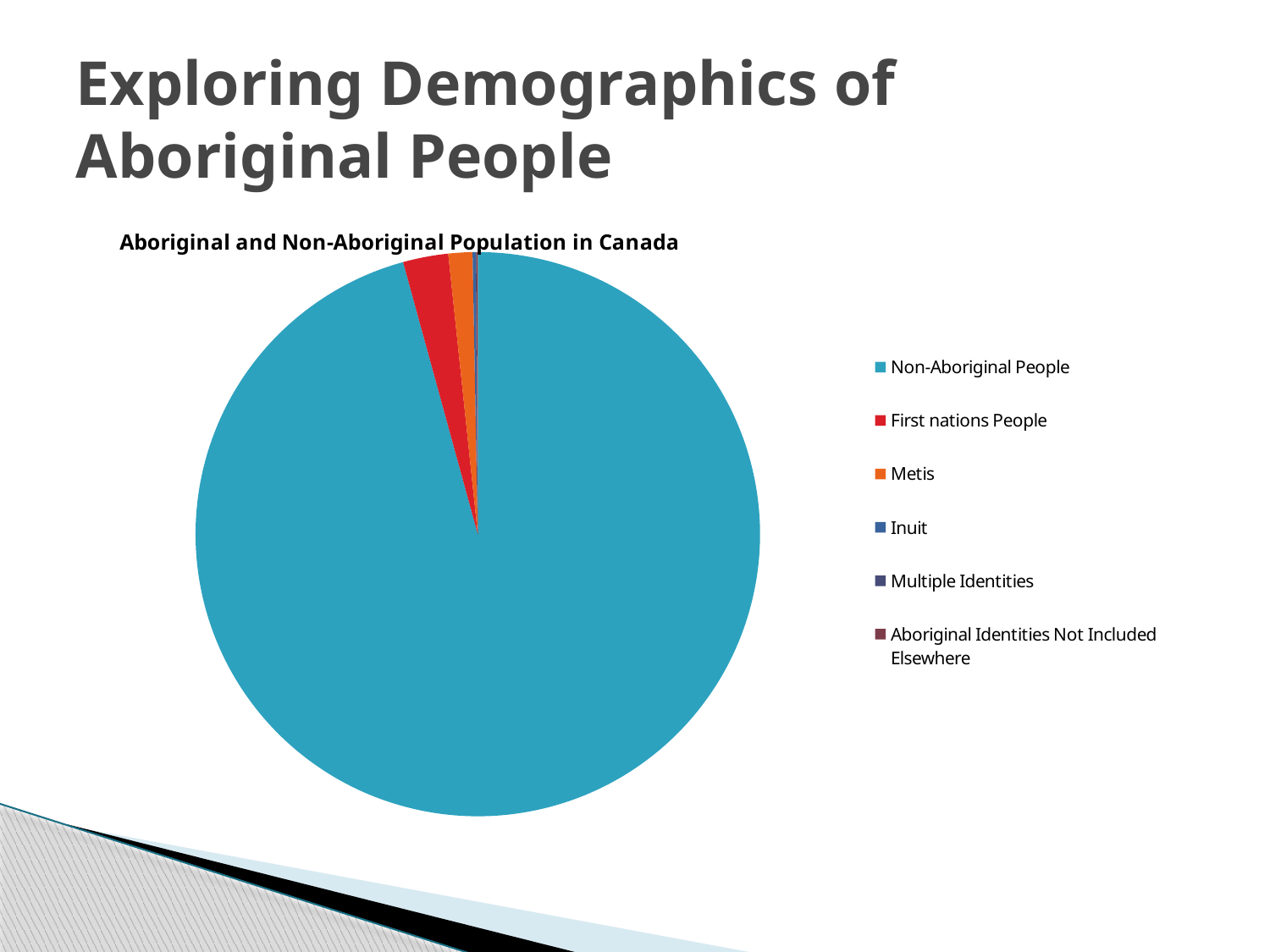
Which category is shown in red in the pie chart? First nations People What is the title of the chart? Aboriginal and Non-Aboriginal Population in Canada Which slice is larger, First nations People or Metis? First nations People What kind of chart is shown on the slide? pie chart Which category has the largest slice of the pie? Non-Aboriginal People Does the Non-Aboriginal People slice take up more or less than half of the pie? more Which slice is larger, Metis or Inuit? Metis How many categories does the legend of the pie chart list? 6